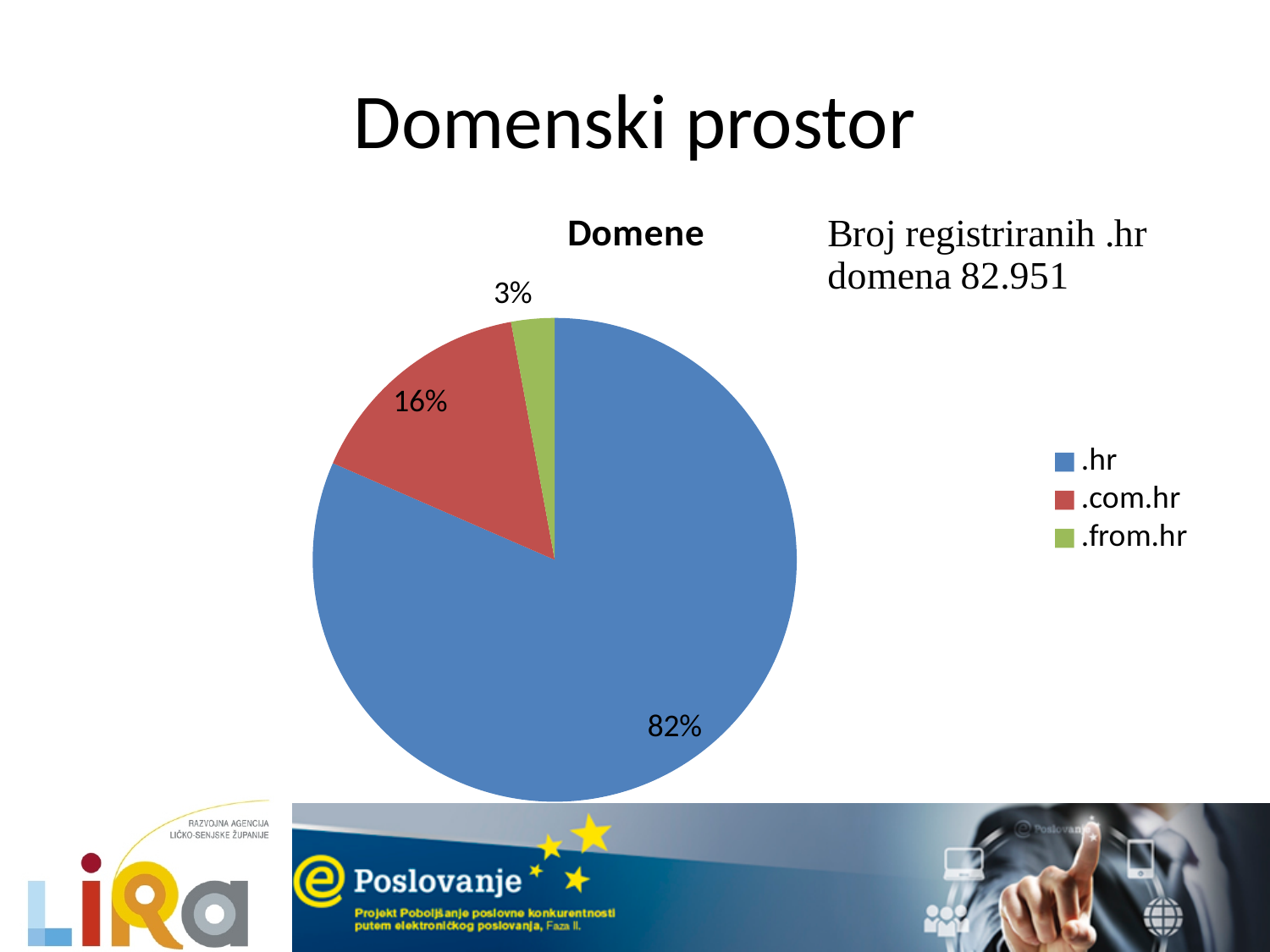
What share of the pie does .com.hr have? 16% What share of the pie does .from.hr have? 3% What colour is the .com.hr slice in the legend? red What is the title of the chart? Domene What share of the pie does .hr have? 82% What kind of chart is shown on the slide? pie chart How many entries does the legend list? 3 Which category has the largest slice of the pie? .hr Which slice is larger, .com.hr or .from.hr? .com.hr How many categories does the pie chart show? 3 What is the difference in percentage points between the .hr and .com.hr slices? 66 Which category has the smallest slice of the pie? .from.hr